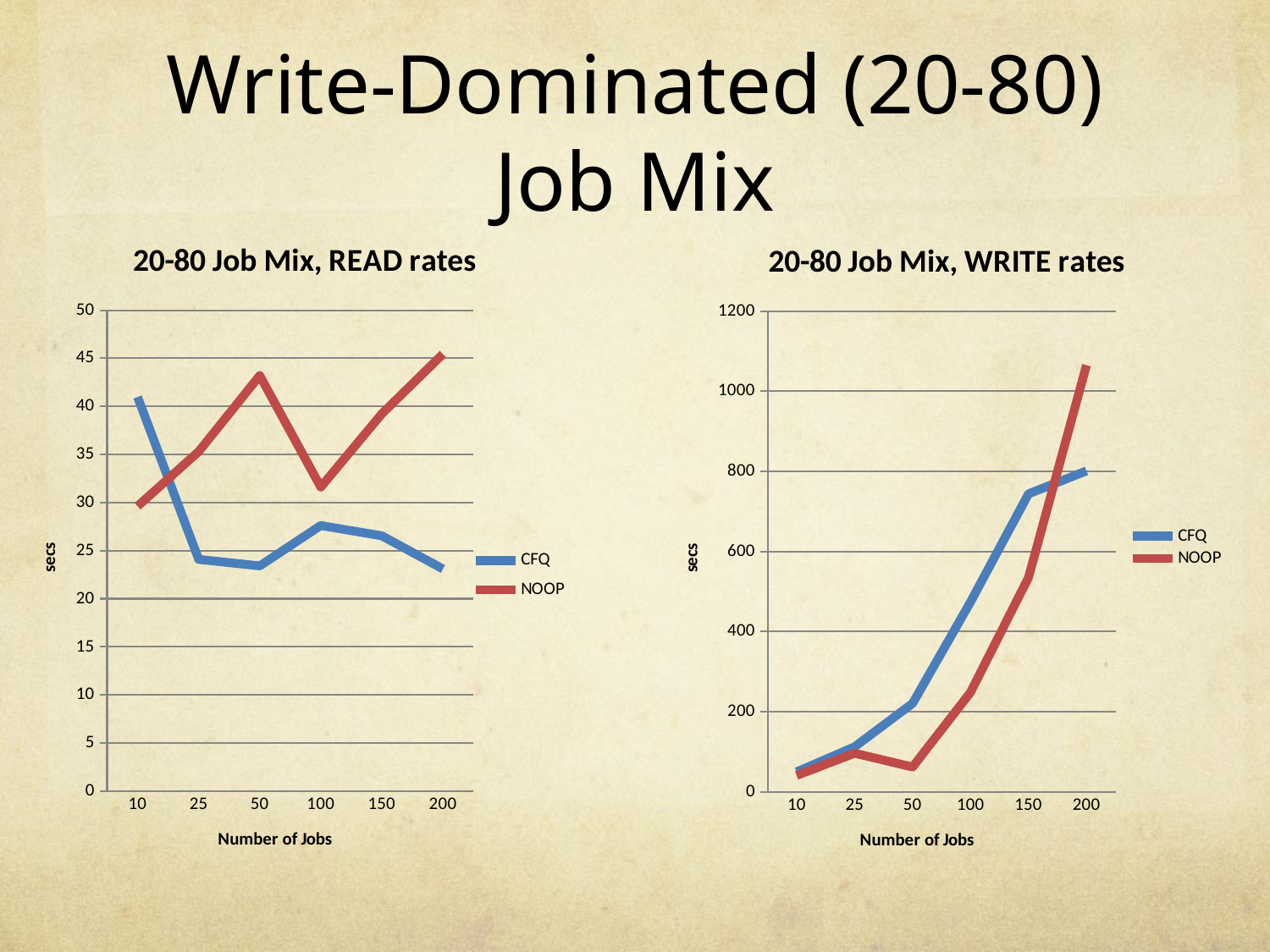
In the "20-80 Job Mix, WRITE rates" chart, at which number of jobs does the NOOP series reach its highest value? 200 In the "20-80 Job Mix, READ rates" chart, is the CFQ value at 10 jobs greater or less than 35? greater In the "20-80 Job Mix, READ rates" chart, which series is higher at 50 jobs, CFQ or NOOP? NOOP How many series does the legend of the "20-80 Job Mix, WRITE rates" chart list? 2 In the "20-80 Job Mix, WRITE rates" chart, is the CFQ value at 50 jobs greater or less than 400? less In the "20-80 Job Mix, WRITE rates" chart, does the CFQ series generally rise or fall as the number of jobs increases? rise In the "20-80 Job Mix, WRITE rates" chart, is the NOOP value at 200 jobs greater or less than 1000? greater In the "20-80 Job Mix, WRITE rates" chart, which series is higher at 100 jobs, CFQ or NOOP? CFQ What kind of chart is the "20-80 Job Mix, READ rates" chart? line chart In the "20-80 Job Mix, READ rates" chart, which series is higher at 10 jobs, CFQ or NOOP? CFQ How many Number of Jobs categories are shown on the x axis of the "20-80 Job Mix, READ rates" chart? 6